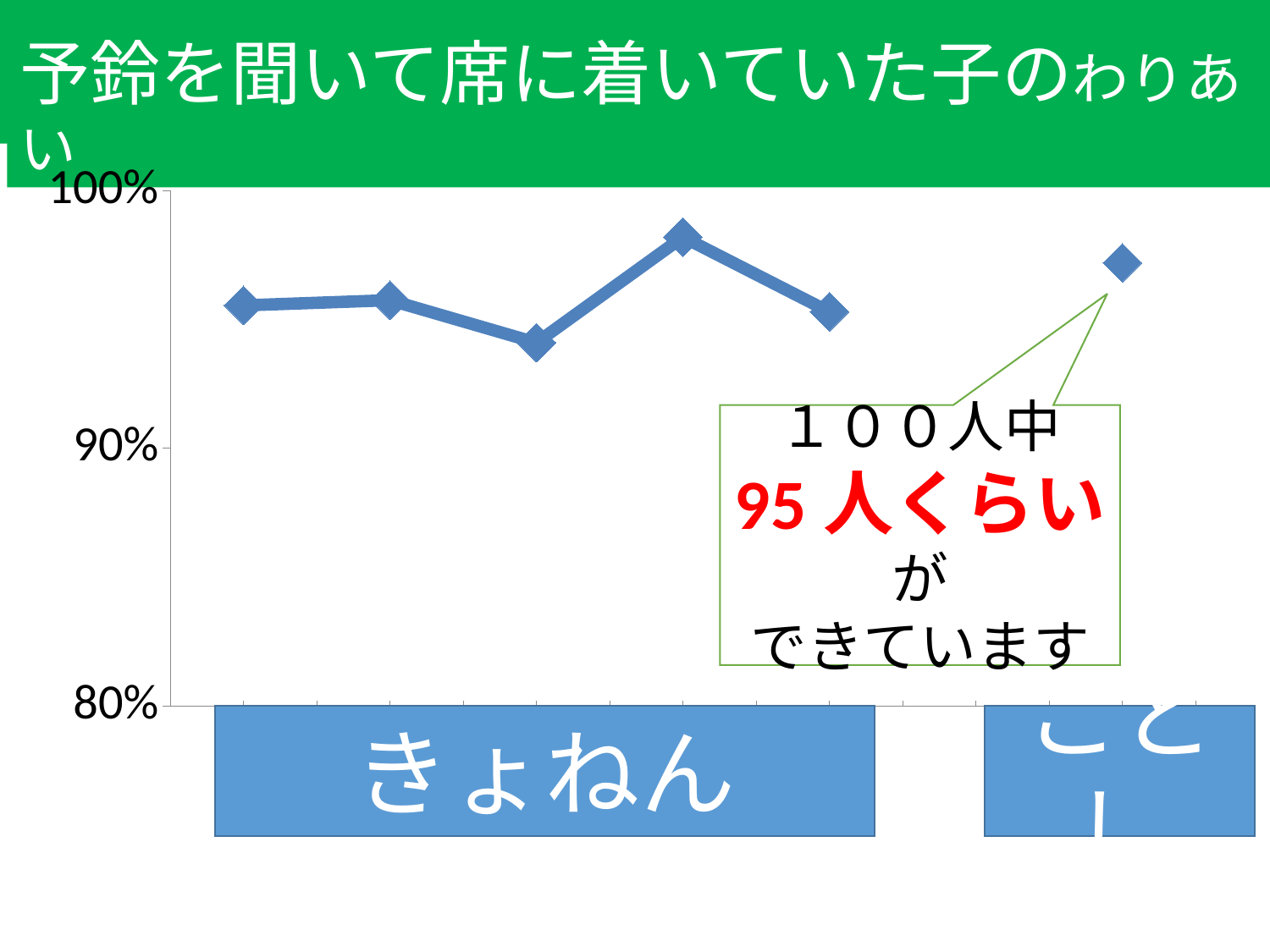
What is the title of the chart? 予鈴を聞いて席に着いていた子のわりあい Are any of the plotted points below 90%? No Is the value of the separate point on the right (ことし) greater or less than 90%? greater What kind of chart is shown on the slide? line chart Is the value of the third plotted point greater or less than 90%? greater How many data points are plotted on the chart? 6 How many points are connected by the line on the left (きょねん) section of the chart? 5 What is the lowest value shown on the vertical axis? 80%